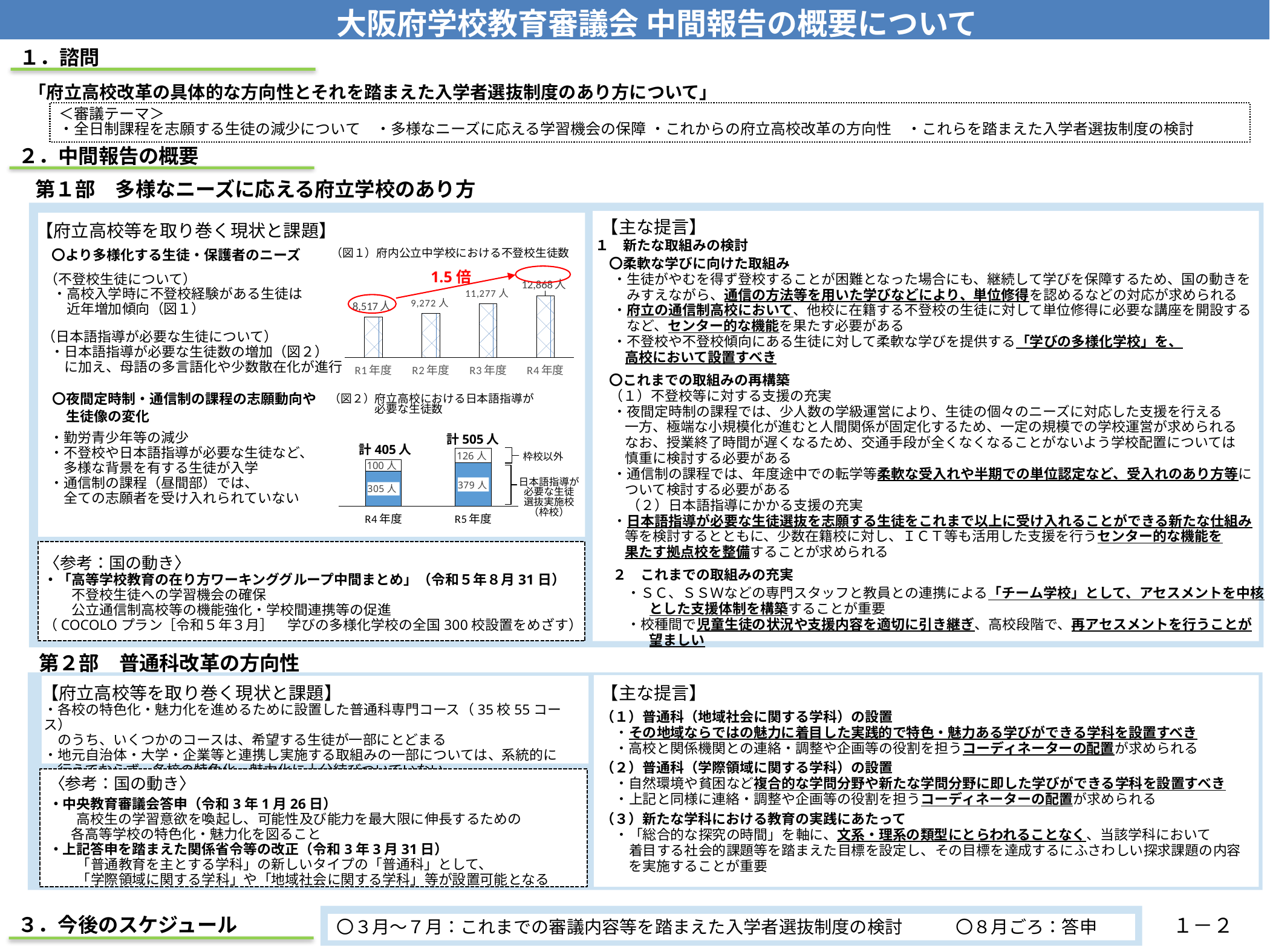
In Figure 2 (府立高校における日本語指導が必要な生徒数), what is the total for R5年度? 計505人 In Figure 1 (府内公立中学校における不登校生徒数), which year has the highest value? R4年度 In Figure 2 (府立高校における日本語指導が必要な生徒数), what is the 枠校以外 value for R4年度? 100人 In Figure 1 (府内公立中学校における不登校生徒数), which year has the lowest value? R1年度 In Figure 1 (府内公立中学校における不登校生徒数), do the values rise or fall from R1年度 to R4年度? rise In Figure 1 (府内公立中学校における不登校生徒数), what is the value for R1年度? 8,517人 In Figure 1 (府内公立中学校における不登校生徒数), what is the difference between R4年度 and R1年度? 4,351人 In Figure 2 (府立高校における日本語指導が必要な生徒数), what is the 日本語指導が必要な生徒選抜実施校（枠校） value for R5年度? 379人 In Figure 1 (府内公立中学校における不登校生徒数), what is the value for R4年度? 12,868人 In Figure 1 (府内公立中学校における不登校生徒数), what multiplier is annotated between R1年度 and R4年度? 1.5倍 In Figure 2 (府立高校における日本語指導が必要な生徒数), what is the difference between the totals for R5年度 and R4年度? 100人 In Figure 1 (府内公立中学校における不登校生徒数), how many years are plotted? 4